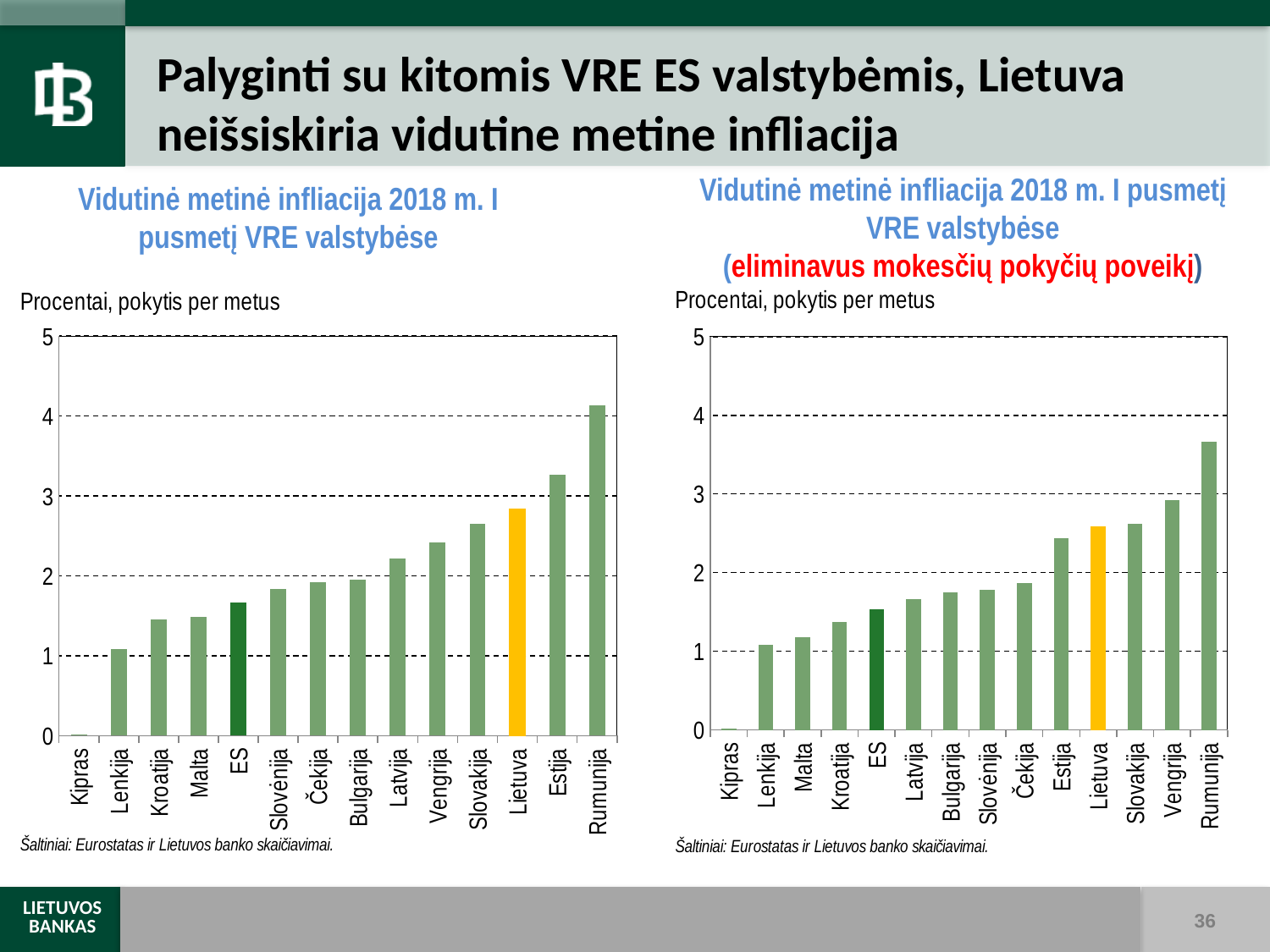
In the left chart, is the value for Lietuva greater or less than 3? less In the left chart, which is larger, the value for Estija or the value for Lietuva? Estija In the left chart, which category has the highest value? Rumunija In the left chart, which category has the lowest value? Kipras In the right chart (eliminavus mokesčių pokyčių poveikį), which category has the highest value? Rumunija In the right chart (eliminavus mokesčių pokyčių poveikį), which is larger, the value for Vengrija or the value for Lietuva? Vengrija In the left chart, what colour is the bar for Lietuva? Yellow What kind of chart is the left chart, 'Vidutinė metinė infliacija 2018 m. I pusmetį VRE valstybėse'? Bar chart In the right chart (eliminavus mokesčių pokyčių poveikį), is the value for Rumunija greater or less than 4? less In the left chart, how many countries/categories are shown on the x axis? 14 In the right chart (eliminavus mokesčių pokyčių poveikį), do the bar values rise or fall from left to right along the x axis? Rise In the left chart, is the value for Rumunija greater or less than 4? greater